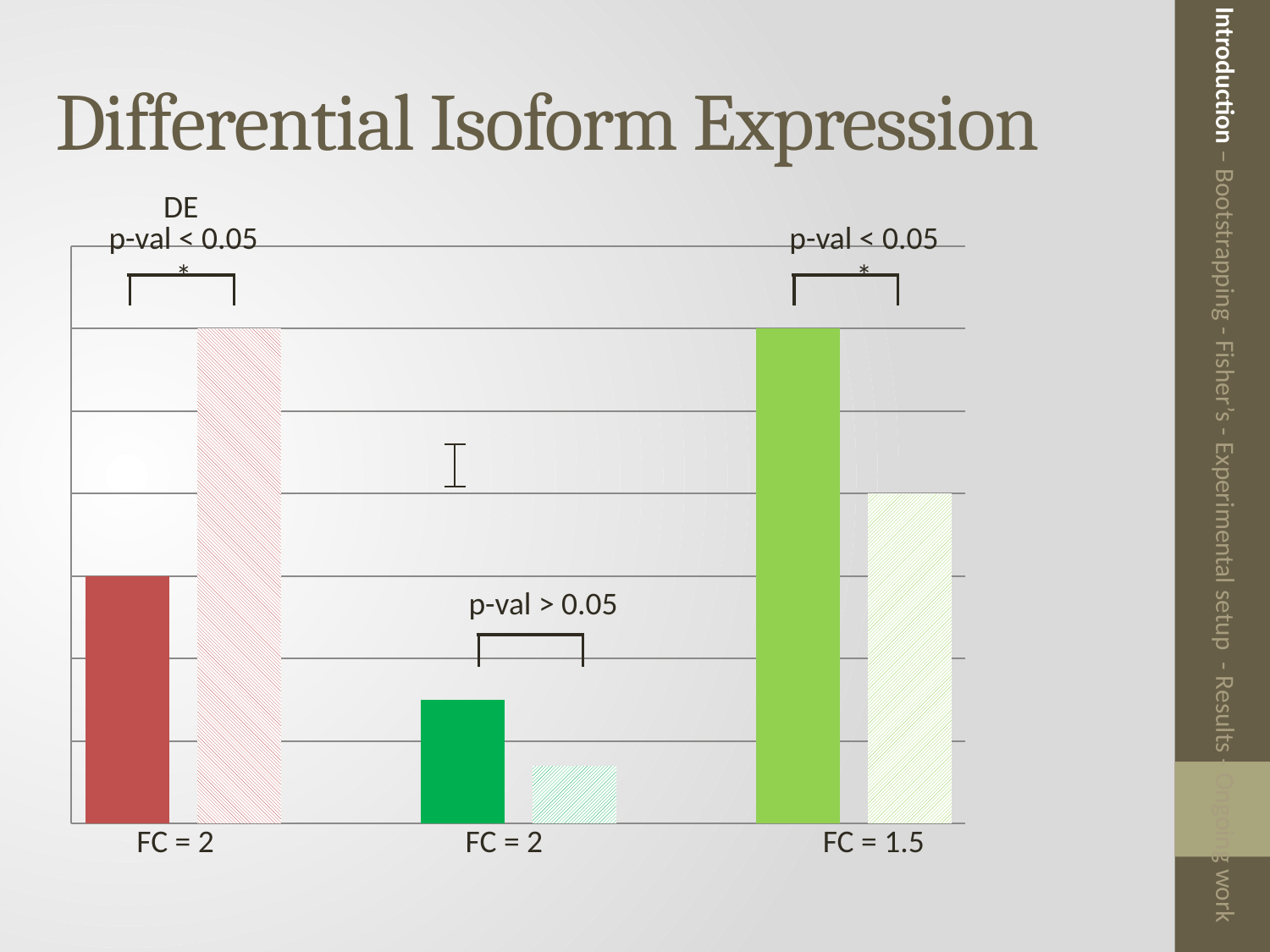
How many bars are plotted in total on the chart? 6 In the leftmost group (red bars), which bar is taller: the solid bar or the hatched bar? the hatched bar How many groups of bars are shown along the x axis? 3 What is the title of the slide containing the chart? Differential Isoform Expression What p-value annotation is shown above the rightmost group of bars (FC = 1.5)? p-val < 0.05 Which group of bars contains the shortest bar on the chart? the middle group (FC = 2, green) What is the x-axis label of the leftmost group of bars? FC = 2 What p-value annotation is shown above the middle group of bars? p-val > 0.05 In the middle group (green bars), which bar is taller: the solid bar or the hatched bar? the solid bar What is the x-axis label of the rightmost group of bars? FC = 1.5 What kind of chart is shown on the slide? bar chart In the rightmost group (FC = 1.5), which bar is taller: the solid bar or the hatched bar? the solid bar